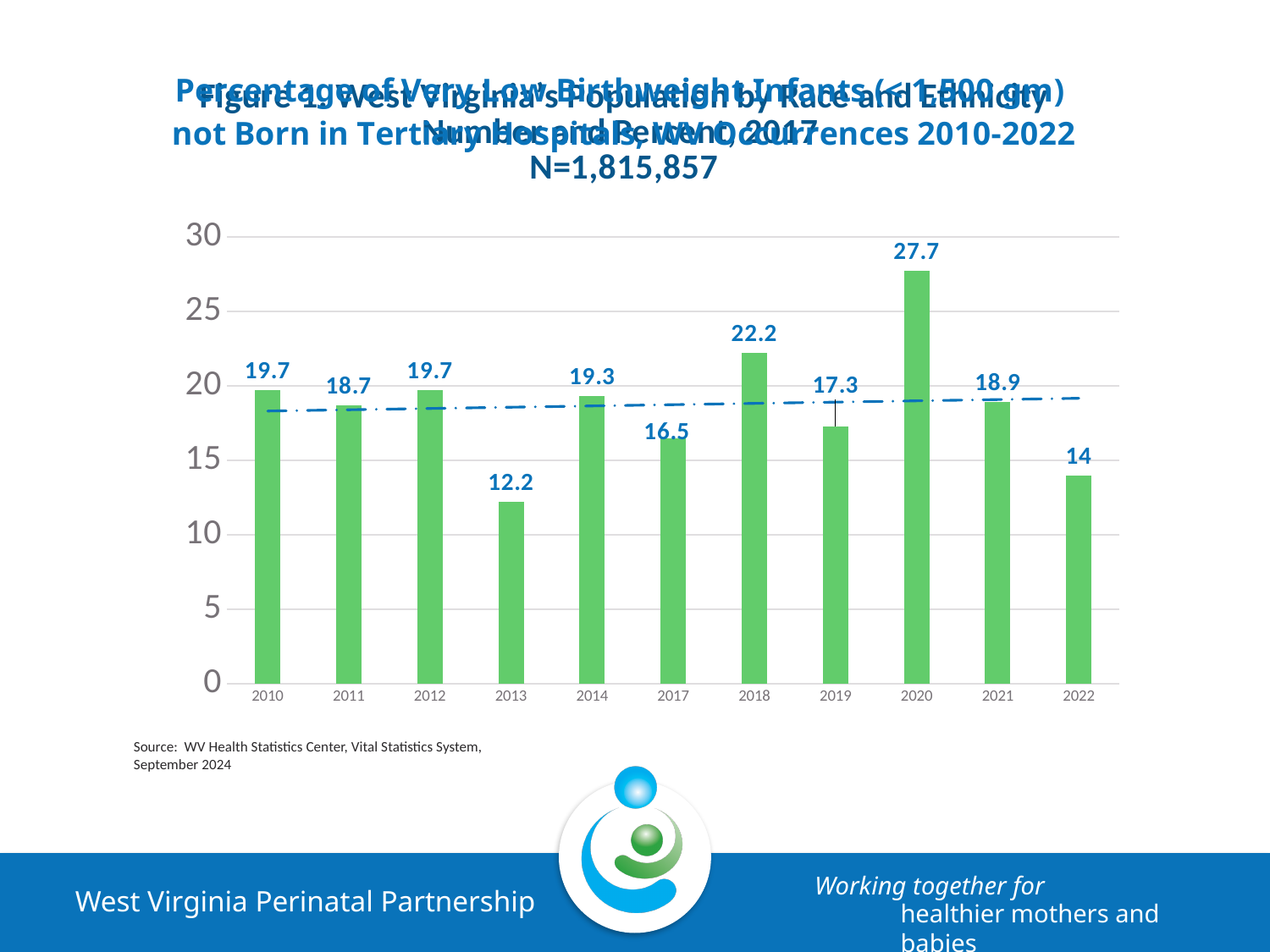
Is the value for 2018 greater or less than 20? greater How many years are shown on the x axis? 11 Which year has the highest value? 2020 Which year has the lowest value? 2013 Which is larger, the value for 2017 or the value for 2019? 2019 What is the value for 2018? 22.2 What kind of chart is this? bar chart What is the value for 2020? 27.7 What colour are the bars? green What is the difference between the values for 2020 and 2022? 13.7 What is the value for 2022? 14 What is the value for 2013? 12.2